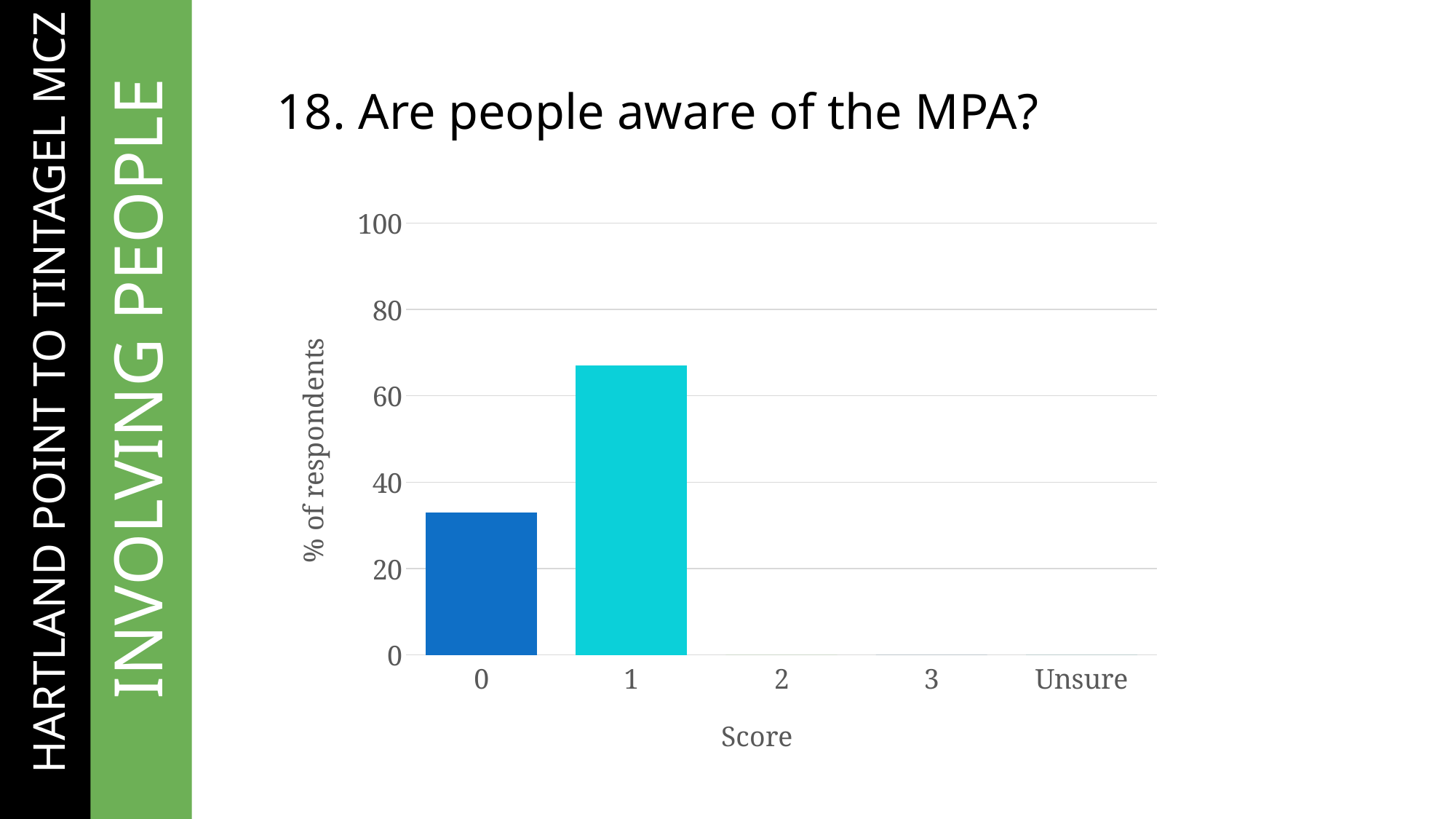
What is the label of the y axis? % of respondents Which score category has the highest percentage of respondents? 1 How many categories are shown on the x axis? 5 What is the value for the Unsure category? 0 What is the label of the x axis? Score What kind of chart is shown on the slide? bar chart What is the value for score 2? 0 Is the value for score 0 greater or less than 40? less Is the value for score 1 greater or less than 60? greater Which is larger, the value for score 0 or the value for score 1? 1 Is the value for score 0 greater or less than 20? greater